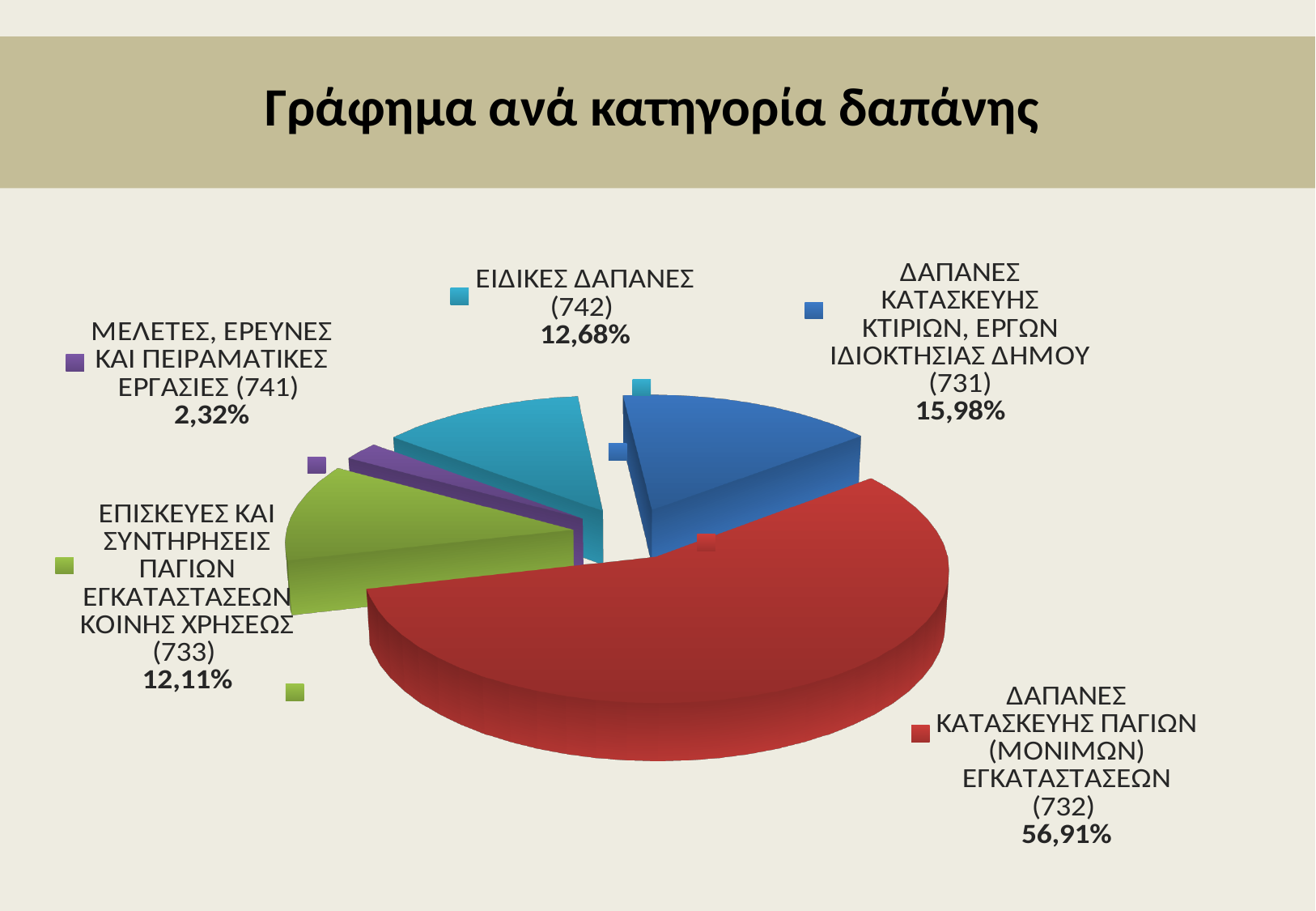
What percentage is shown for ΜΕΛΕΤΕΣ, ΕΡΕΥΝΕΣ ΚΑΙ ΠΕΙΡΑΜΑΤΙΚΕΣ ΕΡΓΑΣΙΕΣ (741)? 2,32% What is the title of the chart? Γράφημα ανά κατηγορία δαπάνης What percentage is shown for ΕΠΙΣΚΕΥΕΣ ΚΑΙ ΣΥΝΤΗΡΗΣΕΙΣ ΠΑΓΙΩΝ ΕΓΚΑΤΑΣΤΑΣΕΩΝ ΚΟΙΝΗΣ ΧΡΗΣΕΩΣ (733)? 12,11% What percentage is shown for ΕΙΔΙΚΕΣ ΔΑΠΑΝΕΣ (742)? 12,68% What kind of chart is shown on the slide? Pie chart Which category has the smallest share of the pie? ΜΕΛΕΤΕΣ, ΕΡΕΥΝΕΣ ΚΑΙ ΠΕΙΡΑΜΑΤΙΚΕΣ ΕΡΓΑΣΙΕΣ (741) What percentage is shown for ΔΑΠΑΝΕΣ ΚΑΤΑΣΚΕΥΗΣ ΚΤΙΡΙΩΝ, ΕΡΓΩΝ ΙΔΙΟΚΤΗΣΙΑΣ ΔΗΜΟΥ (731)? 15,98% Which category has the largest share of the pie? ΔΑΠΑΝΕΣ ΚΑΤΑΣΚΕΥΗΣ ΠΑΓΙΩΝ (ΜΟΝΙΜΩΝ) ΕΓΚΑΤΑΣΤΑΣΕΩΝ (732) What colour is the slice for ΔΑΠΑΝΕΣ ΚΑΤΑΣΚΕΥΗΣ ΠΑΓΙΩΝ (ΜΟΝΙΜΩΝ) ΕΓΚΑΤΑΣΤΑΣΕΩΝ (732)? Red Which has the larger share: ΕΙΔΙΚΕΣ ΔΑΠΑΝΕΣ (742) or ΕΠΙΣΚΕΥΕΣ ΚΑΙ ΣΥΝΤΗΡΗΣΕΙΣ ΠΑΓΙΩΝ ΕΓΚΑΤΑΣΤΑΣΕΩΝ ΚΟΙΝΗΣ ΧΡΗΣΕΩΣ (733)? ΕΙΔΙΚΕΣ ΔΑΠΑΝΕΣ (742) What is the difference in percentage points between category 732 (56,91%) and category 731 (15,98%)? 40,93 How many categories (slices) does the pie chart have? 5